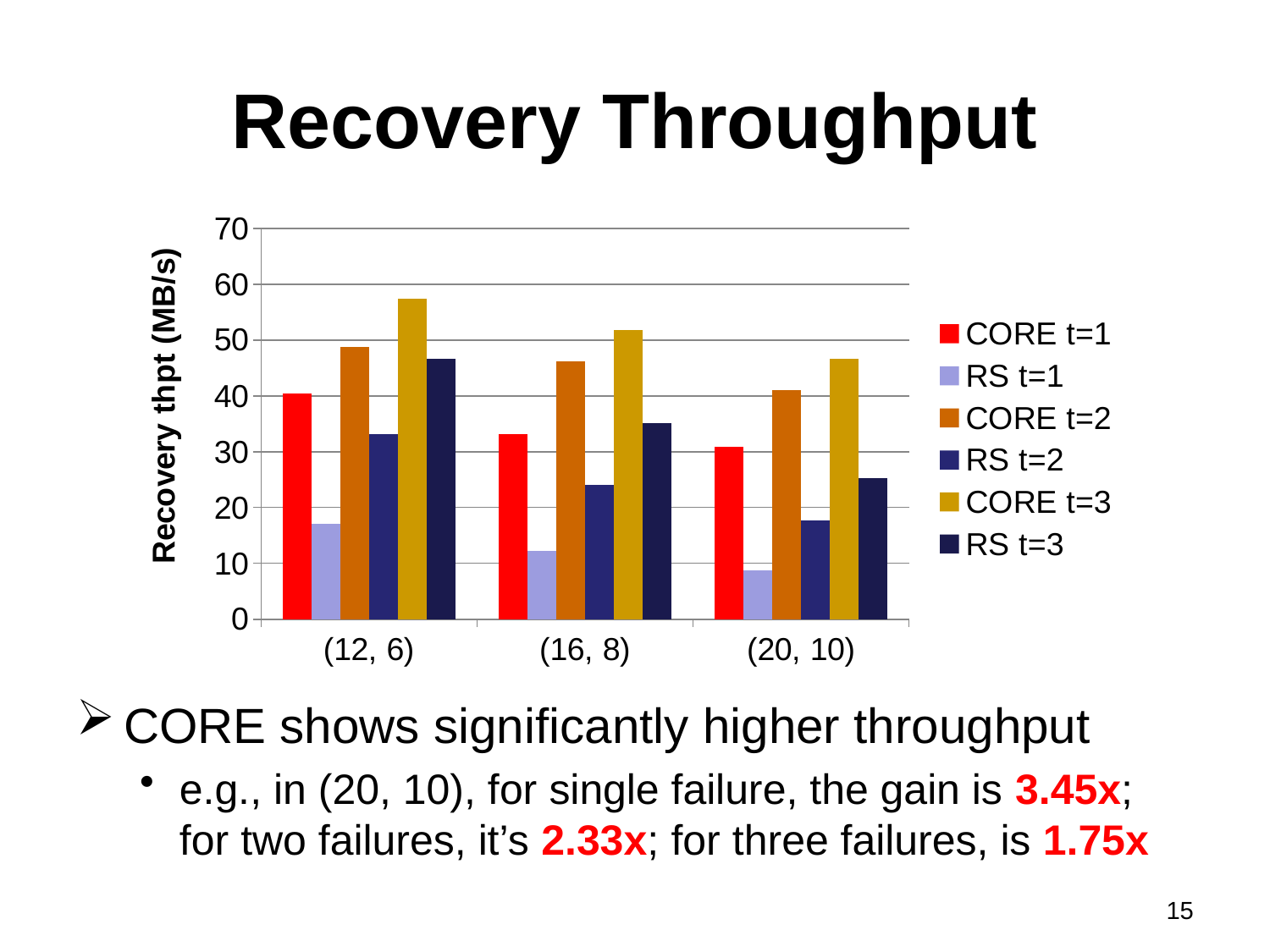
What kind of chart is shown on the slide? bar chart Which series is shown in red? CORE t=1 Is the value for RS t=2 at (16, 8) greater or less than 20? greater How many series does the legend list? 6 Is the value for CORE t=3 at (12, 6) greater or less than 50? greater How many categories are shown on the x axis? 3 For which category is the CORE t=3 bar the highest? (12, 6) For which category is the RS t=1 bar the lowest? (20, 10) Is the value for RS t=1 at (20, 10) greater or less than 10? less What is the title of the y axis? Recovery thpt (MB/s) At (16, 8), which is larger: CORE t=2 or RS t=3? CORE t=2 Do the CORE t=1 values rise or fall from (12, 6) to (20, 10)? fall